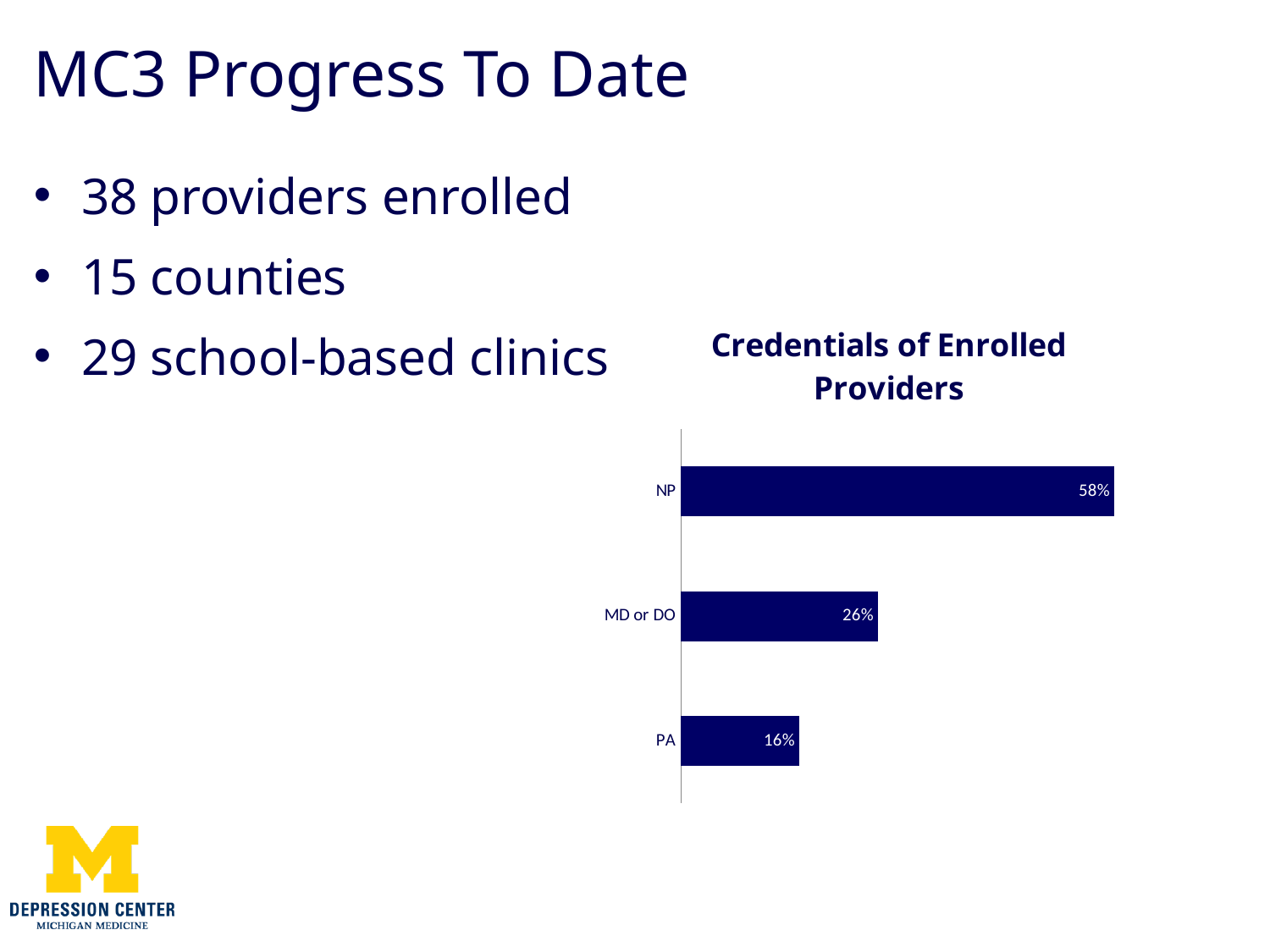
Which credential has the lowest share of enrolled providers? PA What percentage of enrolled providers are PA? 16% What percentage of enrolled providers are NP? 58% What percentage of enrolled providers are MD or DO? 26% What is the title of the chart? Credentials of Enrolled Providers What type of chart is used to show the credentials of enrolled providers? Bar chart Which credential has the highest share of enrolled providers? NP What is the difference in percentage points between NP and MD or DO? 32 What is the combined percentage of NP and MD or DO providers? 84% How many credential categories are shown in the chart? 3 What is the difference in percentage points between MD or DO and PA? 10 Which is larger, the share for MD or DO or the share for PA? MD or DO